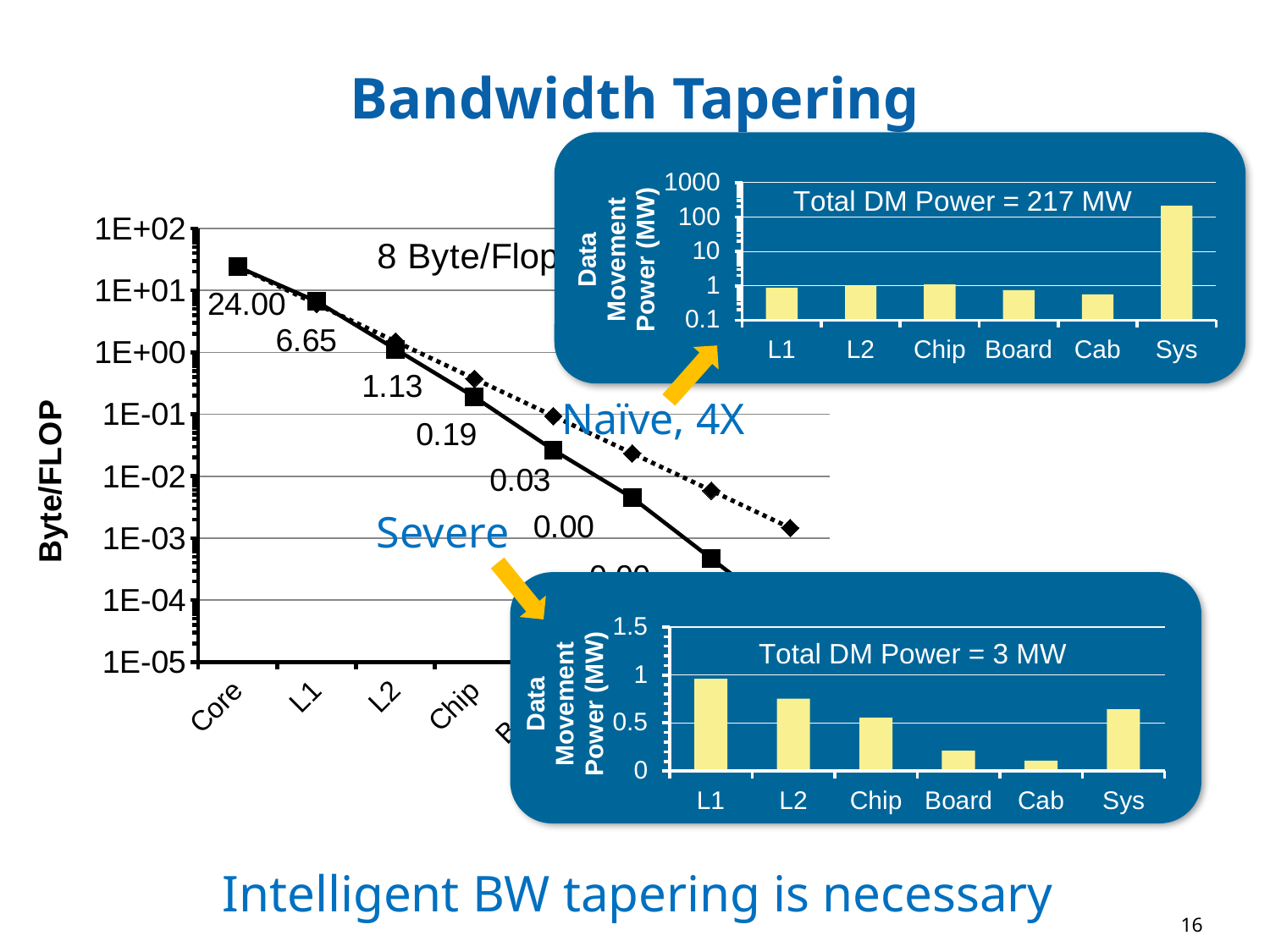
In the chart titled 'Total DM Power = 217 MW', which category has the highest data movement power? Sys How many categories are shown on the x axis of the chart titled 'Total DM Power = 3 MW'? 6 In the Byte/FLOP line chart on the left, what value is labelled at L2? 1.13 In the chart titled 'Total DM Power = 3 MW', which category has the highest data movement power? L1 What kind of chart is the chart titled 'Total DM Power = 3 MW'? bar chart In the chart titled 'Total DM Power = 3 MW', is the value for Board greater or less than 0.5? less In the chart titled 'Total DM Power = 217 MW', is the value for Sys greater or less than 100? greater In the chart titled 'Total DM Power = 3 MW', which is larger, the value for L2 or the value for Chip? L2 In the Byte/FLOP line chart on the left, do the values rise or fall moving from Core to the right along the x axis? fall In the Byte/FLOP line chart on the left, what value is labelled at Core? 24.00 In the chart titled 'Total DM Power = 3 MW', which category has the lowest data movement power? Cab In the chart titled 'Total DM Power = 217 MW', is the value for Cab greater or less than 1? less